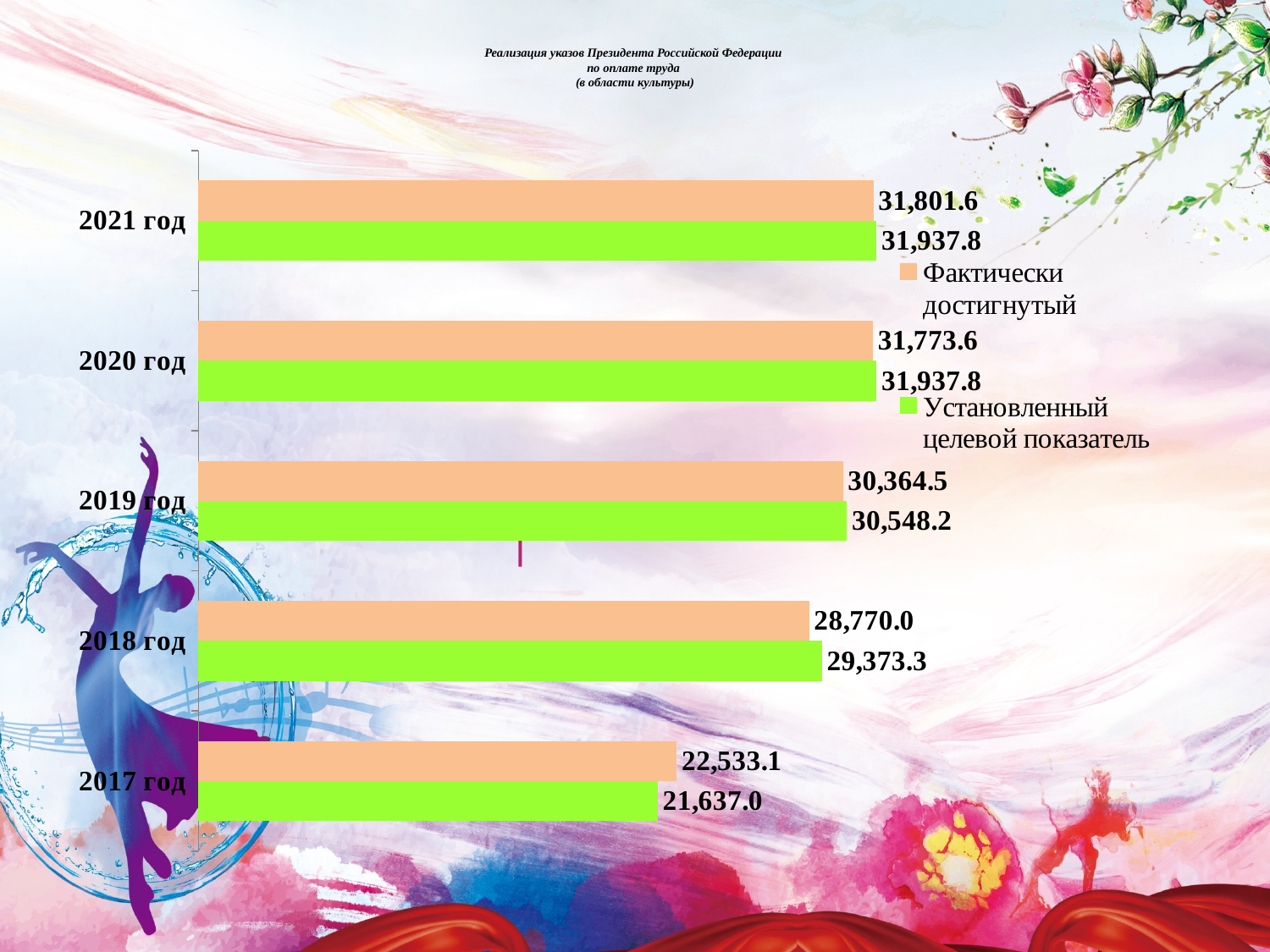
Which year has the lowest value for the 'Установленный целевой показатель' series? 2017 год What is the value of the 'Фактически достигнутый' series for 2017 год? 22,533.1 For 2017 год, which is larger: the 'Фактически достигнутый' value or the 'Установленный целевой показатель' value? Фактически достигнутый What kind of chart is shown on the slide? Bar chart How many years are shown on the chart? 5 Which year has the highest value for the 'Фактически достигнутый' series? 2021 год What is the value of the 'Фактически достигнутый' series for 2021 год? 31,801.6 How many series does the legend list? 2 What is the value of the 'Установленный целевой показатель' series for 2018 год? 29,373.3 For 2019 год, which is larger: the 'Фактически достигнутый' value or the 'Установленный целевой показатель' value? Установленный целевой показатель What is the difference between the 'Установленный целевой показатель' and 'Фактически достигнутый' values for 2017 год? 896.1 What is the difference between the 'Установленный целевой показатель' and 'Фактически достигнутый' values for 2018 год? 603.3